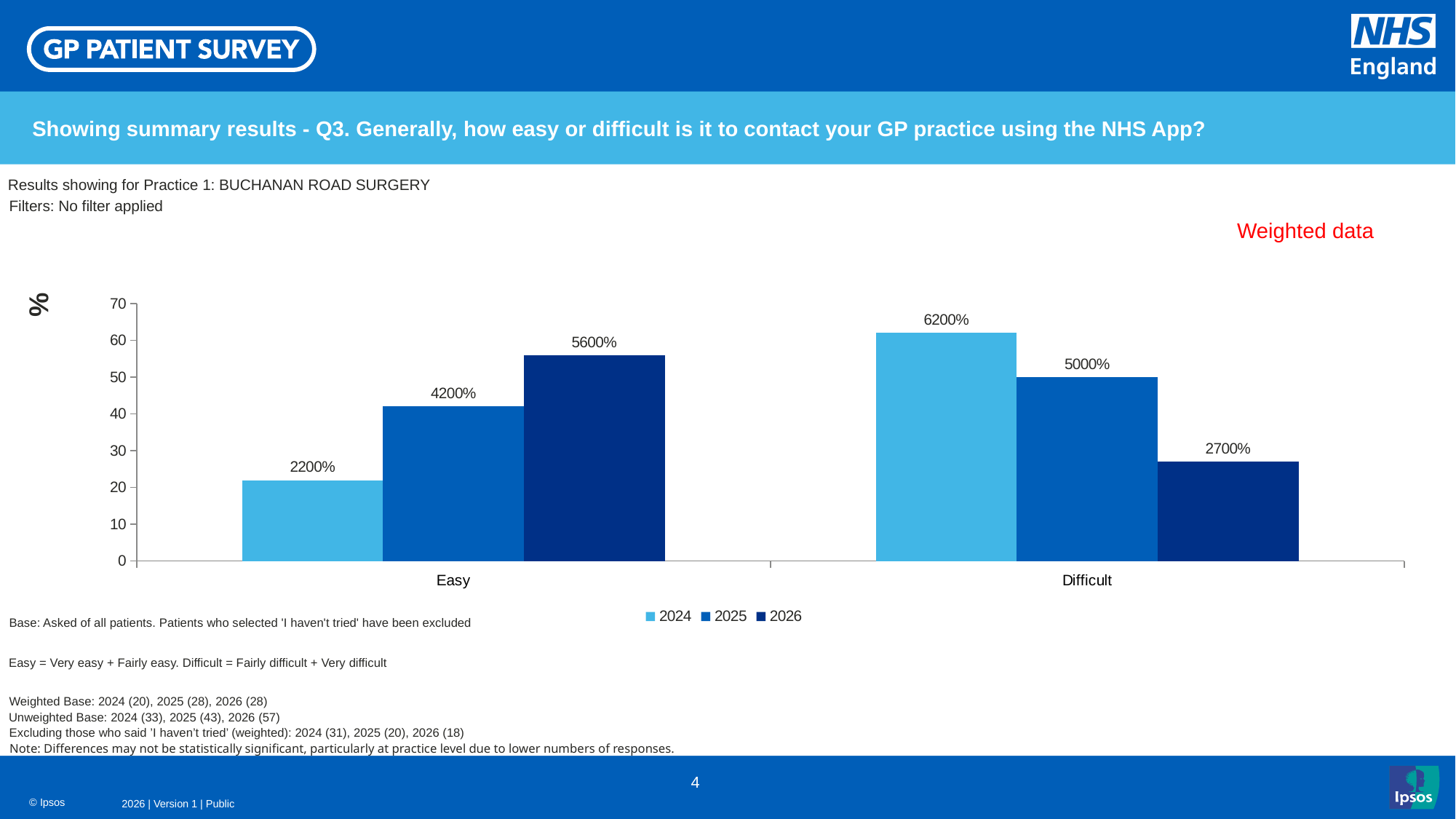
Is the value for 2025 in the Difficult category greater or less than 40? greater Which year has the lowest value in the Difficult category? 2026 What is the value for 2024 in the Easy category? 2200% How many categories are shown on the x axis? 2 Which series is shown in the darkest blue colour? 2026 What kind of chart is shown on the slide? Bar chart What is the value for 2026 in the Difficult category? 2700% Which is larger in the Difficult category, the value for 2024 or the value for 2025? 2024 What is the value for 2024 in the Difficult category? 6200% How many series does the legend list? 3 Which year has the highest value in the Easy category? 2026 What is the value for 2025 in the Easy category? 4200%